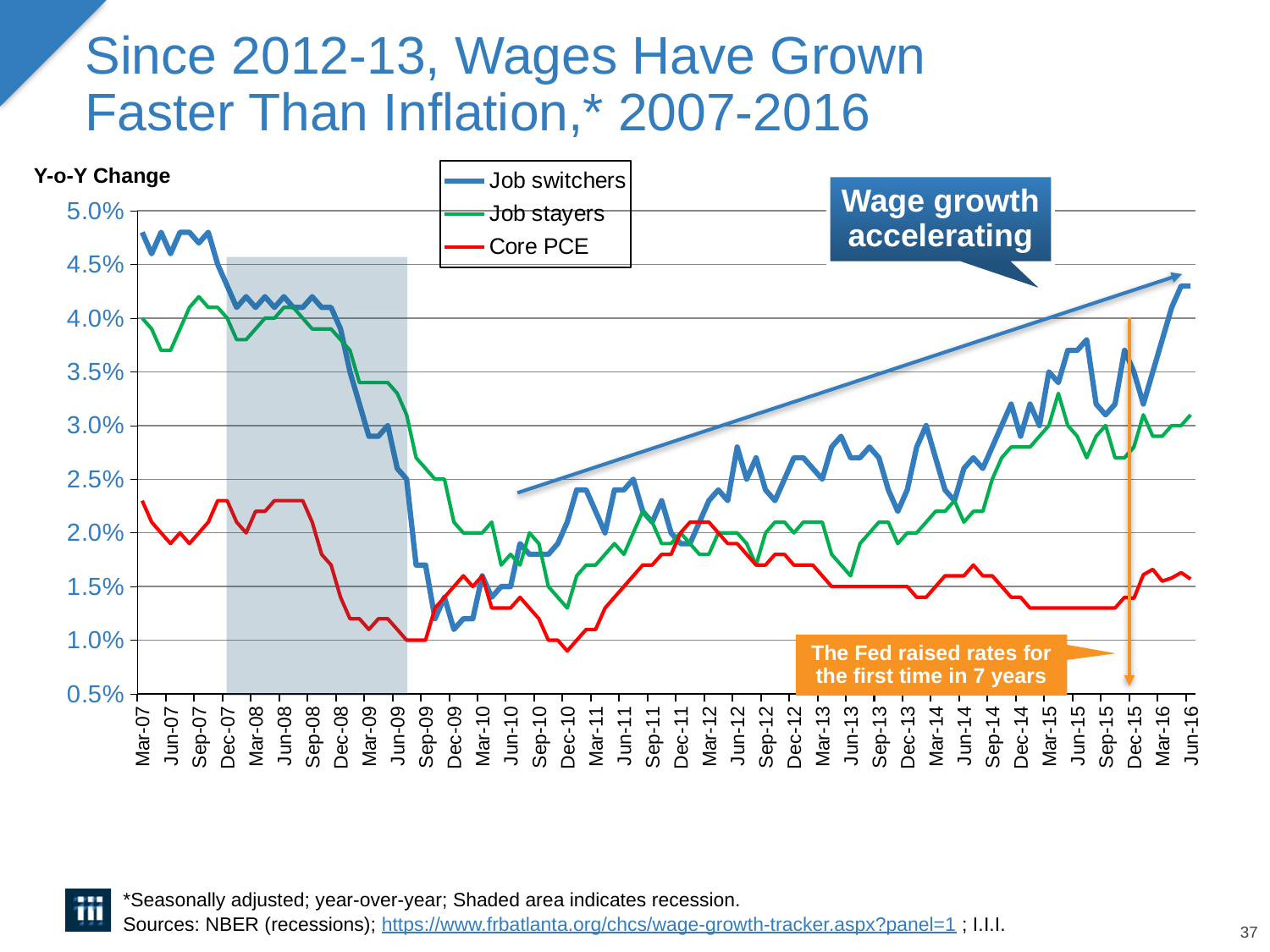
Is the value for Core PCE at Jun-16 greater or less than 2.0%? less Is the value for Core PCE at Dec-10 greater or less than 1.0%? less What does the shaded area on the chart indicate? Recession Which series are listed in the legend? Job switchers, Job stayers, Core PCE Is the value for Job switchers at Mar-07 greater or less than 4.5%? greater How many series does the legend list? 3 At Jun-16, which is larger: Job switchers or Job stayers? Job switchers At Dec-09, which is larger: Job switchers or Core PCE? Core PCE What kind of chart is shown on the slide? Line chart Do the Job switchers values generally rise or fall from Sep-09 to Jun-16? Rise